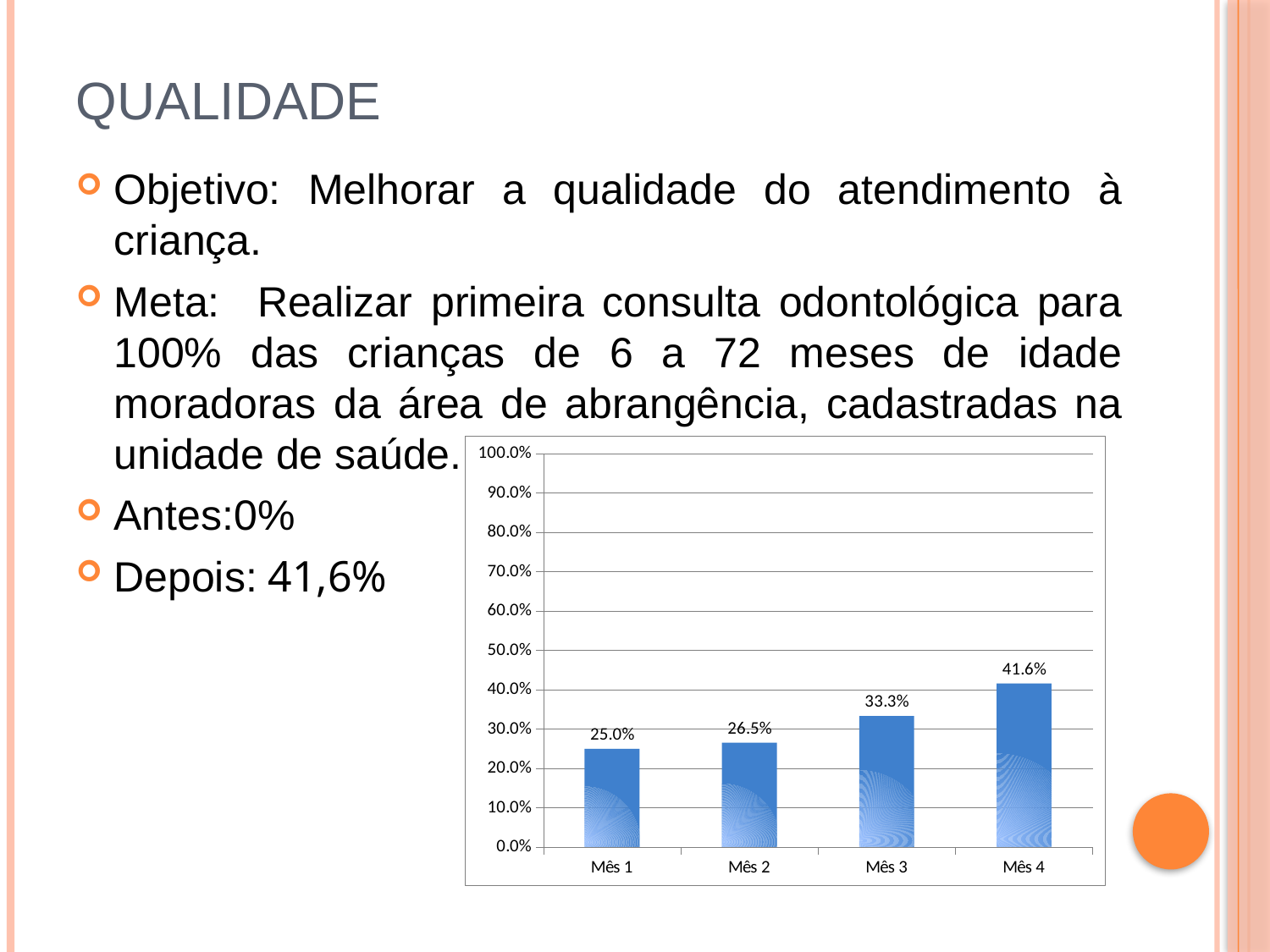
What is the difference between the values for Mês 3 and Mês 2? 6.8% Which is larger, the value for Mês 3 or the value for Mês 2? Mês 3 What is the value for Mês 4? 41.6% What is the value for Mês 1? 25.0% How many months are shown on the x axis? 4 Is the value for Mês 4 greater or less than 50%? less What is the difference between the values for Mês 4 and Mês 1? 16.6% What is the value for Mês 3? 33.3% Which month has the highest value? Mês 4 What is the value for Mês 2? 26.5% Which month has the lowest value? Mês 1 What kind of chart is shown on the slide? bar chart